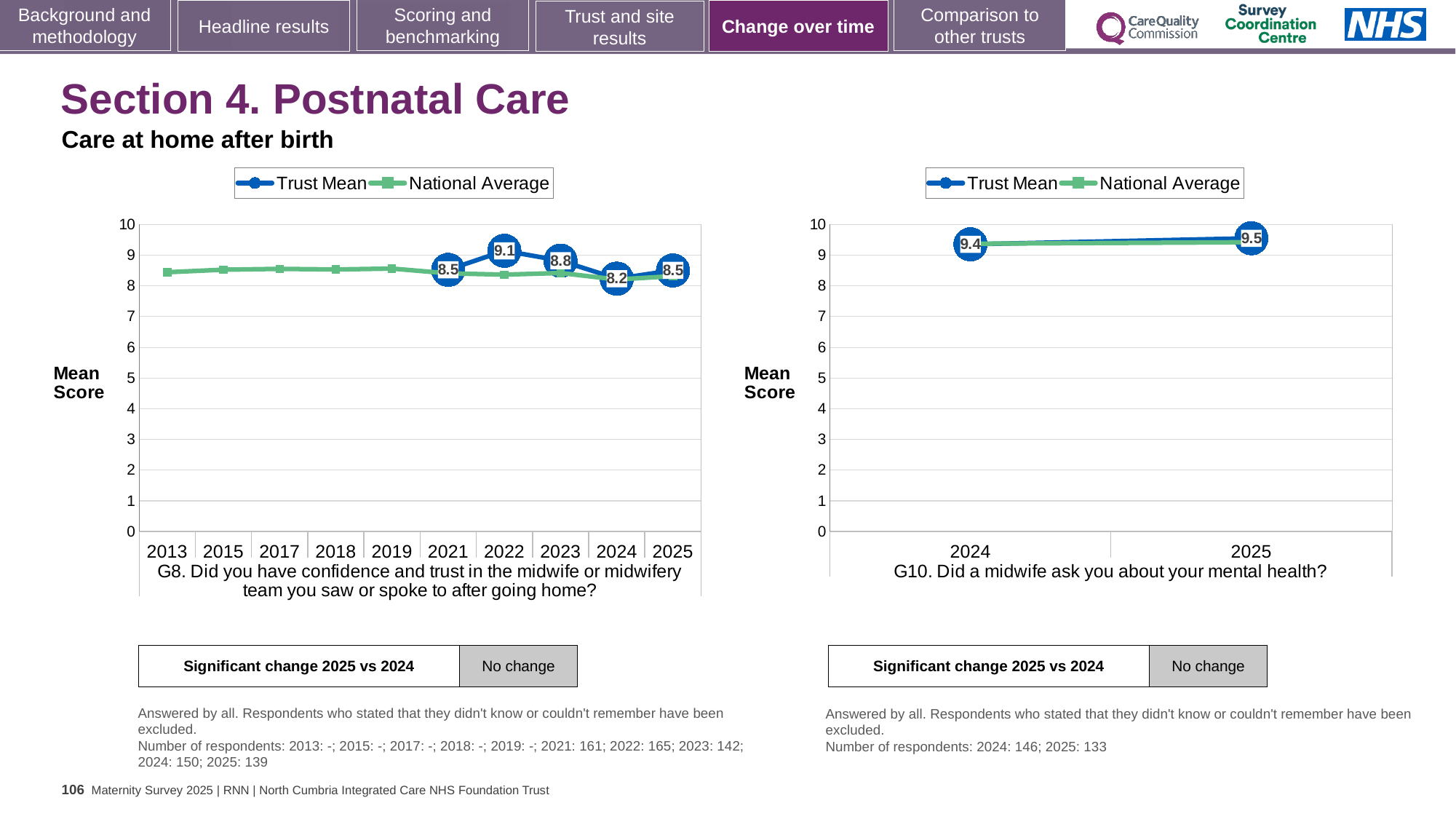
In the G8 chart (left), is the National Average for 2013 greater or less than 8? greater In the G8 chart (left), which year has the highest Trust Mean? 2022 In the G10 chart (right), what is the difference between the Trust Mean in 2025 and in 2024? 0.1 How many years are shown on the x axis of the G8 chart (left)? 10 In the G8 chart (left), is the Trust Mean higher in 2023 or in 2025? 2023 In the G8 chart (left), what is the difference between the Trust Mean in 2022 and in 2024? 0.9 In the G8 chart (left), what is the Trust Mean for 2022? 9.1 What kind of chart is the G10 chart (right)? Line chart In the G10 chart (right), what is the Trust Mean for 2025? 9.5 In the G8 chart (left), which year has the lowest Trust Mean? 2024 In the G8 chart (left), what is the Trust Mean for 2024? 8.2 How many series does the legend of the G10 chart (right) list? 2